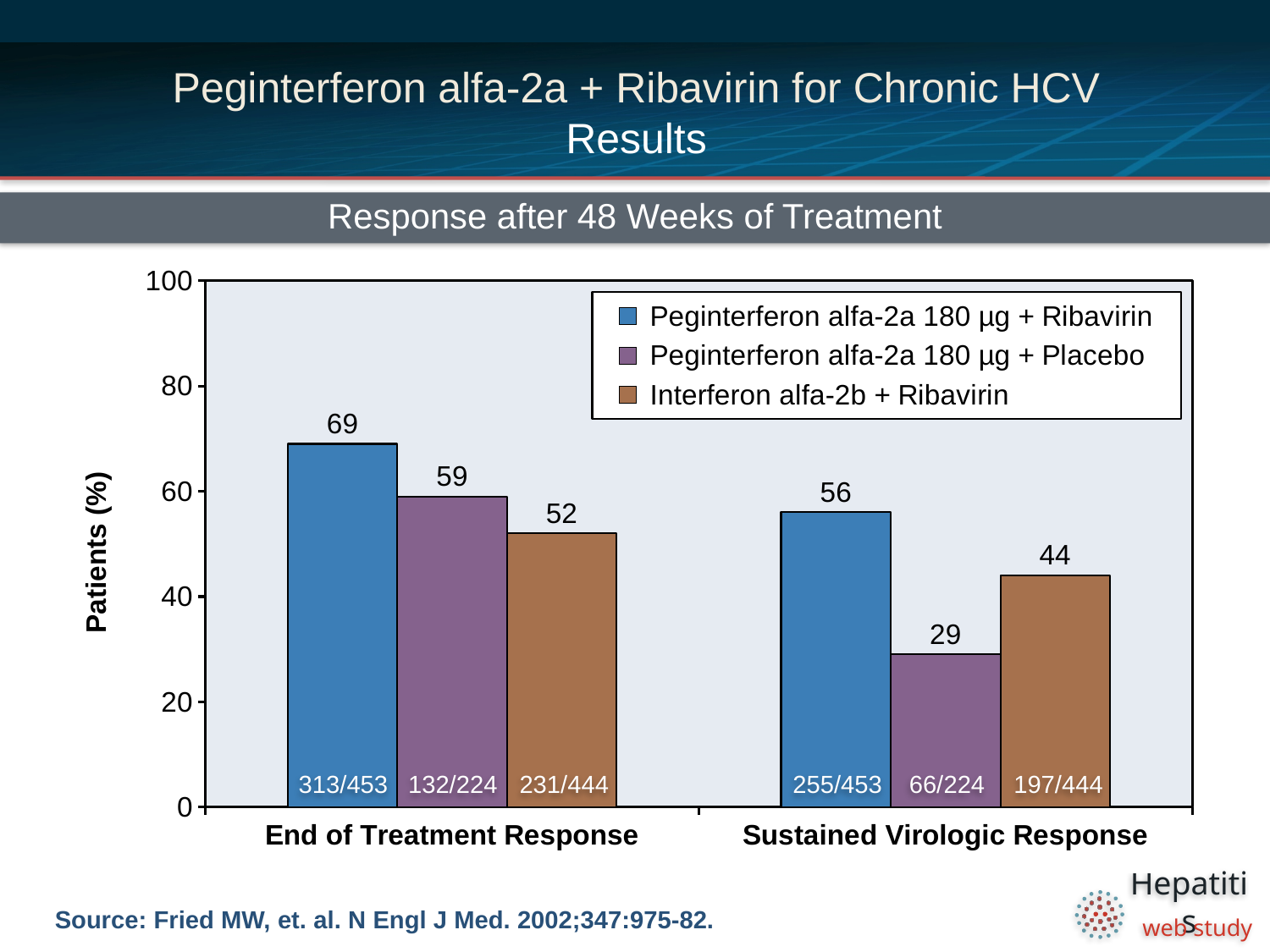
What kind of chart is shown on the slide? bar chart What is the difference between the End of Treatment Response and Sustained Virologic Response values for Peginterferon alfa-2a 180 µg + Placebo? 30 What is the value for Peginterferon alfa-2a 180 µg + Placebo for Sustained Virologic Response? 29 How many categories are shown on the x axis? 2 What is the value for Peginterferon alfa-2a 180 µg + Ribavirin for End of Treatment Response? 69 Which series has the highest value for Sustained Virologic Response? Peginterferon alfa-2a 180 µg + Ribavirin Which series has the lowest value for End of Treatment Response? Interferon alfa-2b + Ribavirin What is the value for Interferon alfa-2b + Ribavirin for Sustained Virologic Response? 44 Which is larger: the Sustained Virologic Response value for Interferon alfa-2b + Ribavirin or for Peginterferon alfa-2a 180 µg + Placebo? Interferon alfa-2b + Ribavirin How many series does the legend list? 3 Is the value for Peginterferon alfa-2a 180 µg + Ribavirin for End of Treatment Response greater or less than 60? greater What is the label of the y axis? Patients (%)